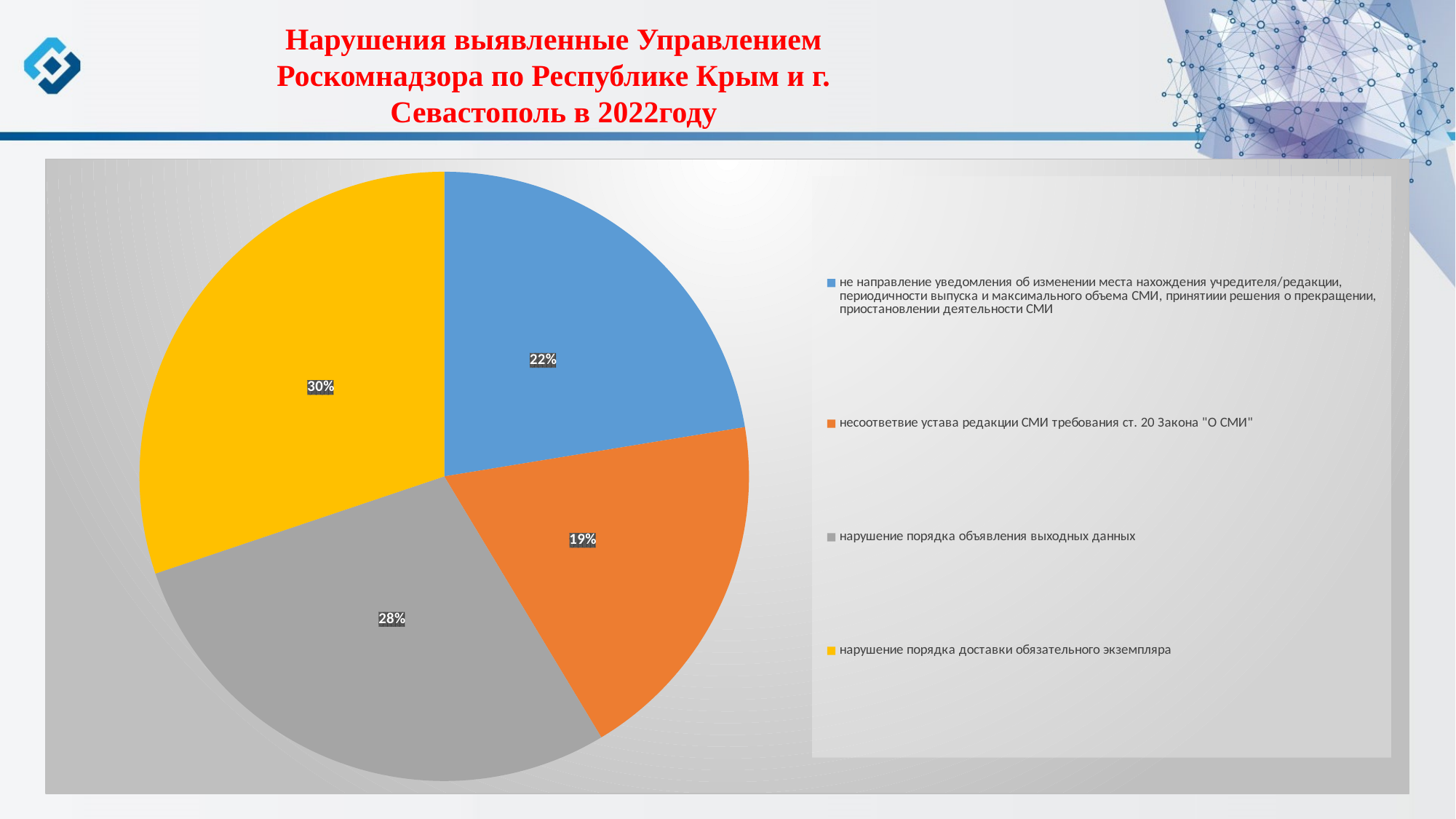
How many entries does the legend list? 4 Which category has the smallest share of the pie? несоответвие устава редакции СМИ требования ст. 20 Закона "О СМИ" What is the difference in percentage points between the yellow slice (30%) and the orange slice (19%)? 11 What share of the pie is labelled "нарушение порядка доставки обязательного экземпляра"? 30% Which category has the largest share of the pie? нарушение порядка доставки обязательного экземпляра What colour is the slice for "нарушение порядка доставки обязательного экземпляра"? Yellow What share of the pie is labelled "несоответвие устава редакции СМИ требования ст. 20 Закона "О СМИ""? 19% What kind of chart is shown on the slide? Pie chart What share of the pie is labelled "нарушение порядка объявления выходных данных"? 28% How many slices does the pie chart have? 4 What percentage is shown for the blue slice of the pie chart? 22% Which is larger: the share for "нарушение порядка объявления выходных данных" or the share for the blue slice? нарушение порядка объявления выходных данных